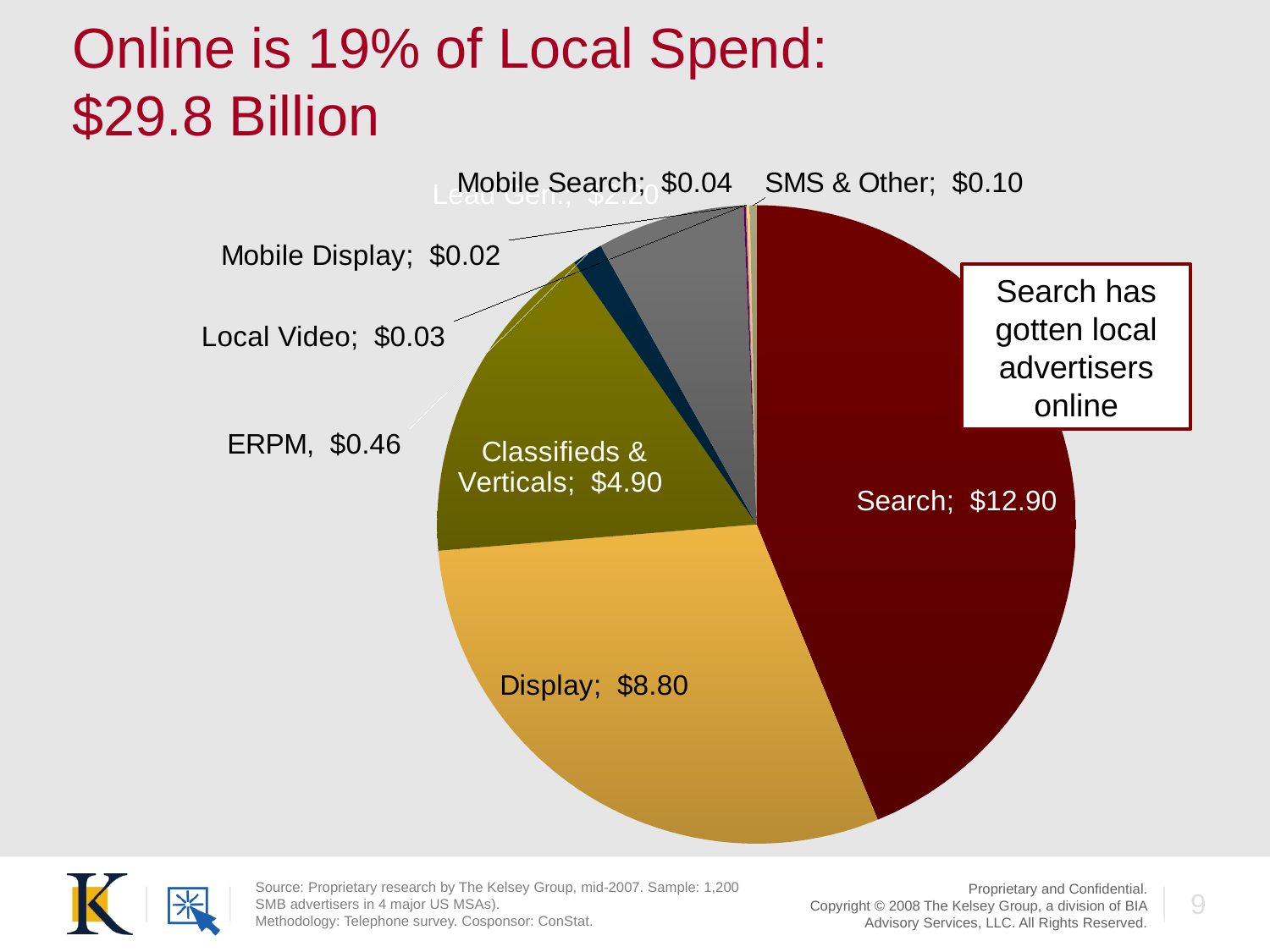
Which category has the largest slice of the pie? Search What is the difference between the Search and Display values? $4.10 What is the title of the slide containing the chart? Online is 19% of Local Spend: $29.8 Billion Which category has the smallest value? Mobile Display What is the value for ERPM? $0.46 What is the value for SMS & Other? $0.10 Which is larger, Display or Classifieds & Verticals? Display What is the value for Display? $8.80 What is the value for Classifieds & Verticals? $4.90 What kind of chart is shown on the slide? pie chart What is the value for Search? $12.90 What is the value for Mobile Display? $0.02